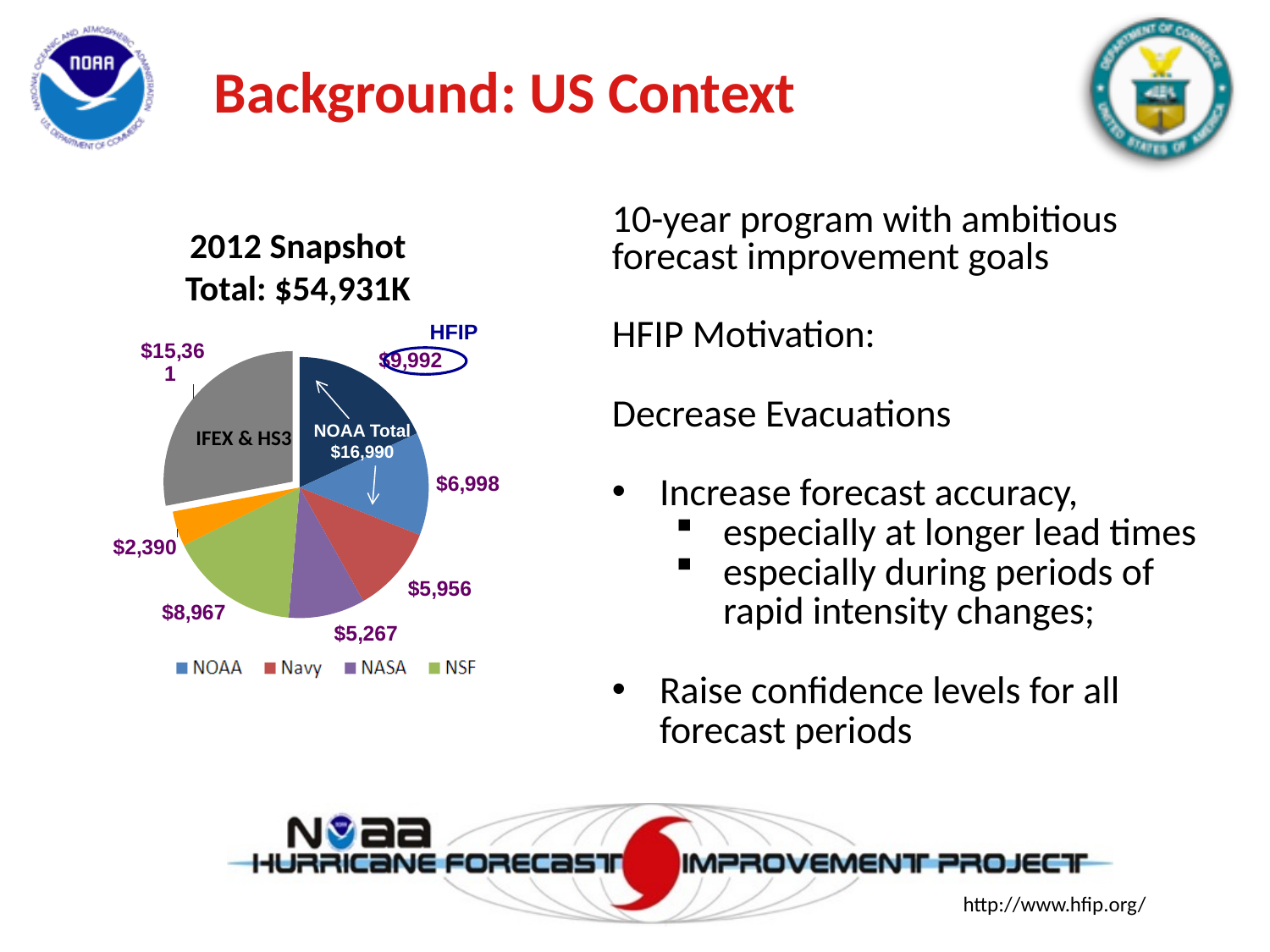
What is the value of the HFIP slice in the pie chart? $9,992 What total is stated in the pie chart's title? $54,931K What is the value of the IFEX & HS3 slice in the pie chart? $15,361 Which labelled slice of the pie chart is the largest? IFEX & HS3 How many slices does the pie chart have? 7 What is the NOAA Total shown on the pie chart? $16,990 What is the difference between the IFEX & HS3 slice ($15,361) and the HFIP slice ($9,992)? $5,369 How many entries does the pie chart's legend list? 4 What is the title of the pie chart? 2012 Snapshot Total: $54,931K What kind of chart is shown on the slide? pie chart Which is larger in the pie chart, the $8,967 slice or the $6,998 slice? $8,967 What is the value of the smallest slice in the pie chart? $2,390